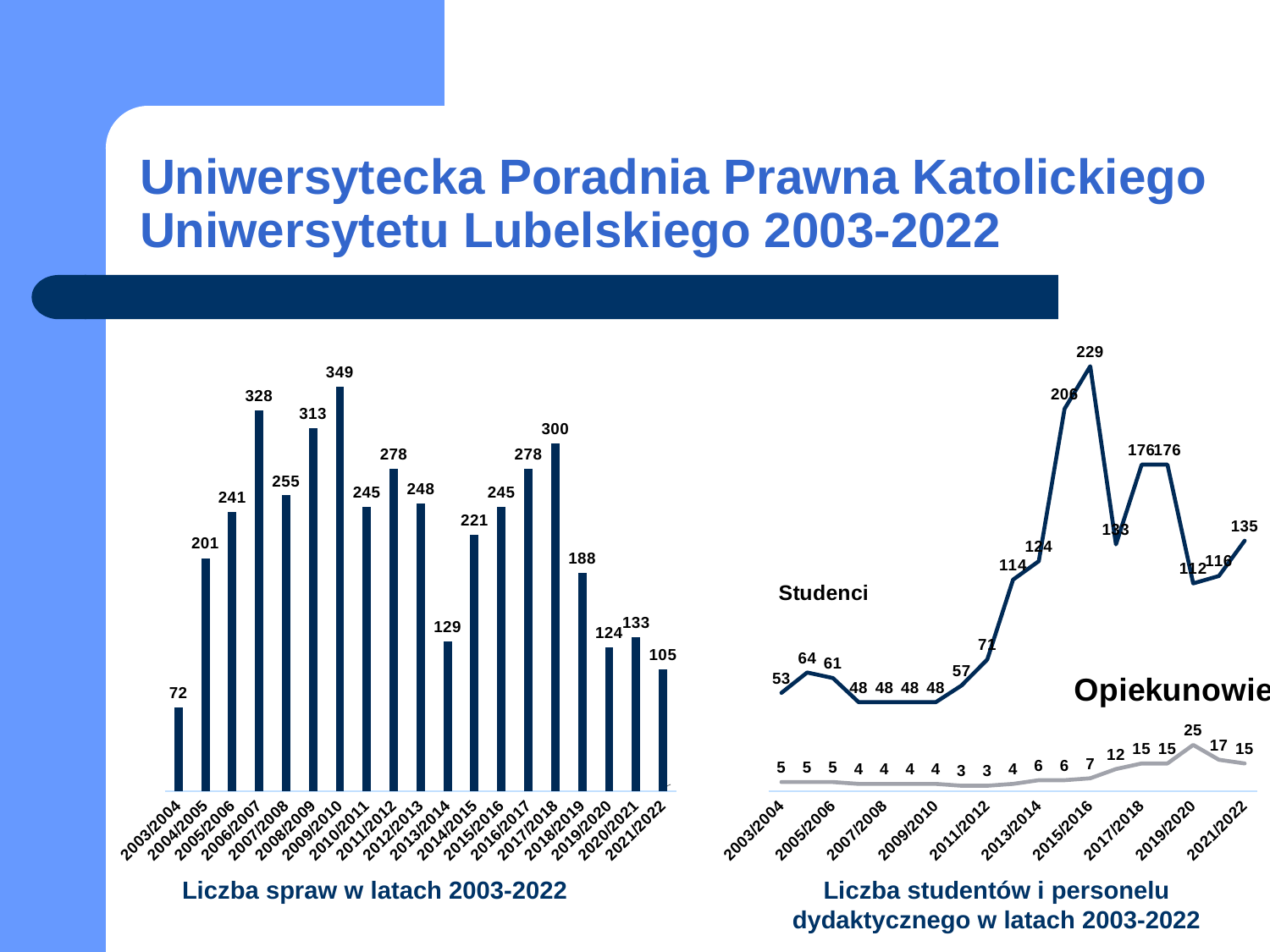
In the right chart 'Liczba studentów i personelu dydaktycznego w latach 2003-2022', what is the Opiekunowie value for 2019/2020? 25 In the left chart 'Liczba spraw w latach 2003-2022', which year has the lowest value? 2003/2004 In the left chart 'Liczba spraw w latach 2003-2022', which is larger: the value for 2006/2007 or for 2008/2009? 2006/2007 In the left chart 'Liczba spraw w latach 2003-2022', which year has the highest value? 2009/2010 How many bars are in the left chart 'Liczba spraw w latach 2003-2022'? 19 How many series are plotted in the right chart 'Liczba studentów i personelu dydaktycznego w latach 2003-2022'? 2 What kind of chart is the right chart, 'Liczba studentów i personelu dydaktycznego w latach 2003-2022'? line chart What kind of chart is the left chart, 'Liczba spraw w latach 2003-2022'? bar chart In the right chart 'Liczba studentów i personelu dydaktycznego w latach 2003-2022', what is the Studenci value for 2021/2022? 135 In the right chart 'Liczba studentów i personelu dydaktycznego w latach 2003-2022', what is the highest value of the Studenci series? 229 In the left chart 'Liczba spraw w latach 2003-2022', what is the value for 2009/2010? 349 In the left chart 'Liczba spraw w latach 2003-2022', what is the difference between the values for 2017/2018 and 2018/2019? 112